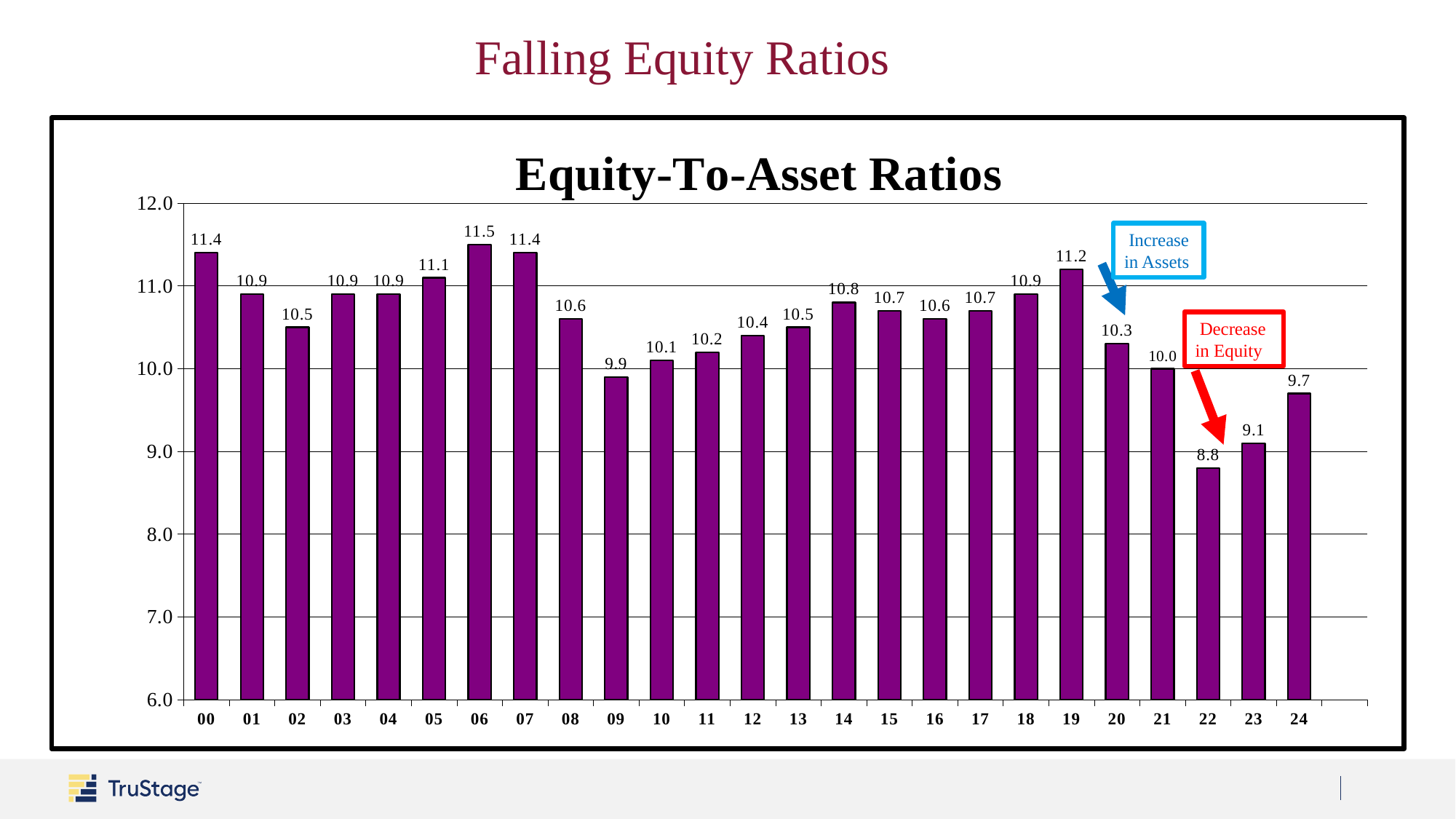
What is the difference between the equity-to-asset ratios for 19 and 20? 0.9 How many years are shown on the x axis of the chart? 25 What is the title of the chart? Equity-To-Asset Ratios Do the equity-to-asset ratios rise or fall from 19 to 22? fall Is the value for 21 greater or less than 11.0? less What is the equity-to-asset ratio for 06? 11.5 Which is larger, the equity-to-asset ratio for 09 or for 14? 14 What is the equity-to-asset ratio for 24? 9.7 What is the equity-to-asset ratio for 22? 8.8 Which year has the highest equity-to-asset ratio? 06 Which year has the lowest equity-to-asset ratio? 22 What kind of chart is shown on the slide? bar chart